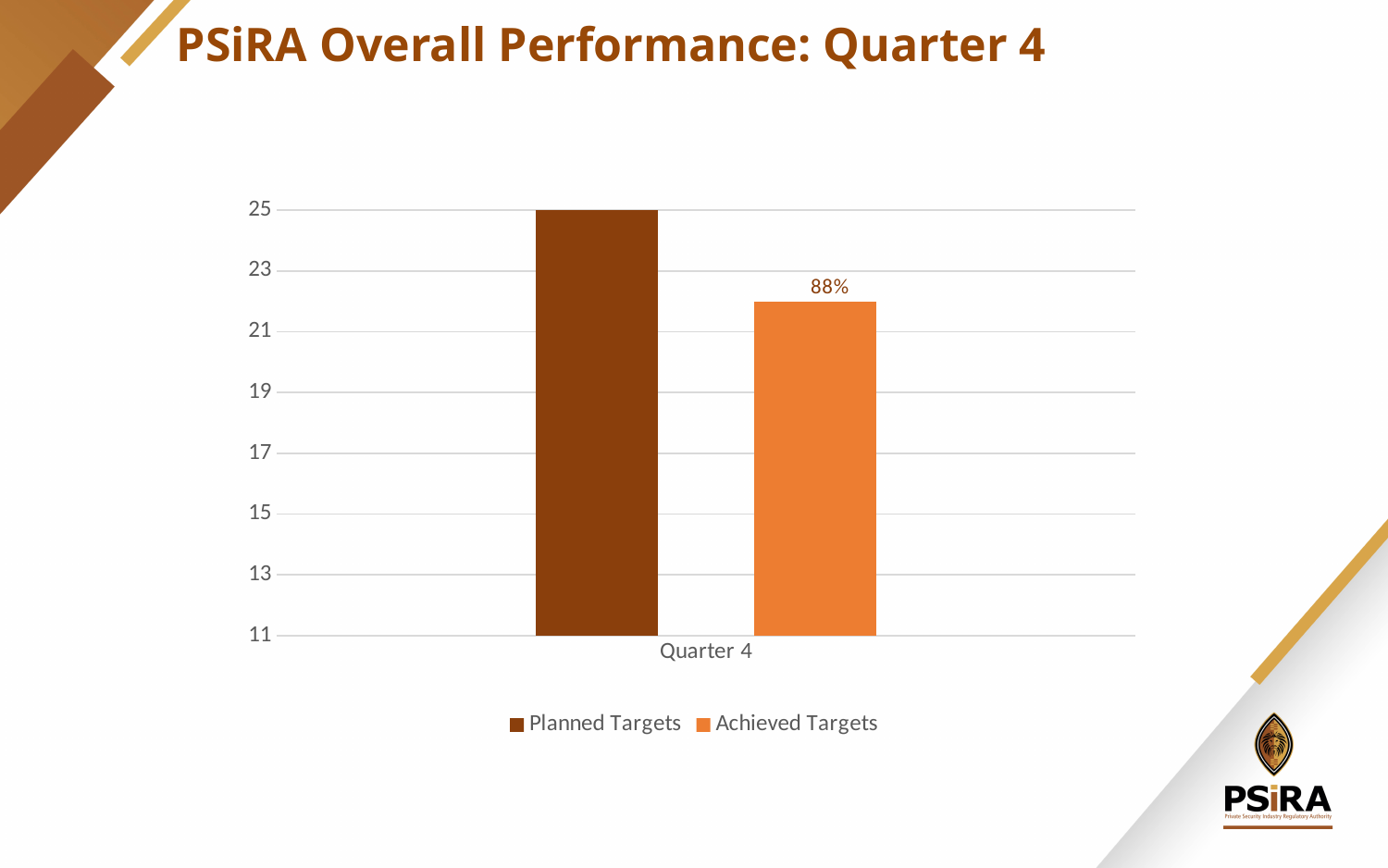
Which is larger for Quarter 4, Planned Targets or Achieved Targets? Planned Targets What is the title of the slide? PSiRA Overall Performance: Quarter 4 Which series has the highest bar? Planned Targets Which series is shown in orange? Achieved Targets How many series does the legend list? 2 Is the value for Achieved Targets greater or less than 21? greater What kind of chart is shown on the slide? bar chart What is the value of the Planned Targets bar for Quarter 4? 25 How many categories are shown on the x axis? 1 Which series has the lowest bar? Achieved Targets Is the value for Achieved Targets greater or less than 23? less What data label is printed on the Achieved Targets bar? 88%